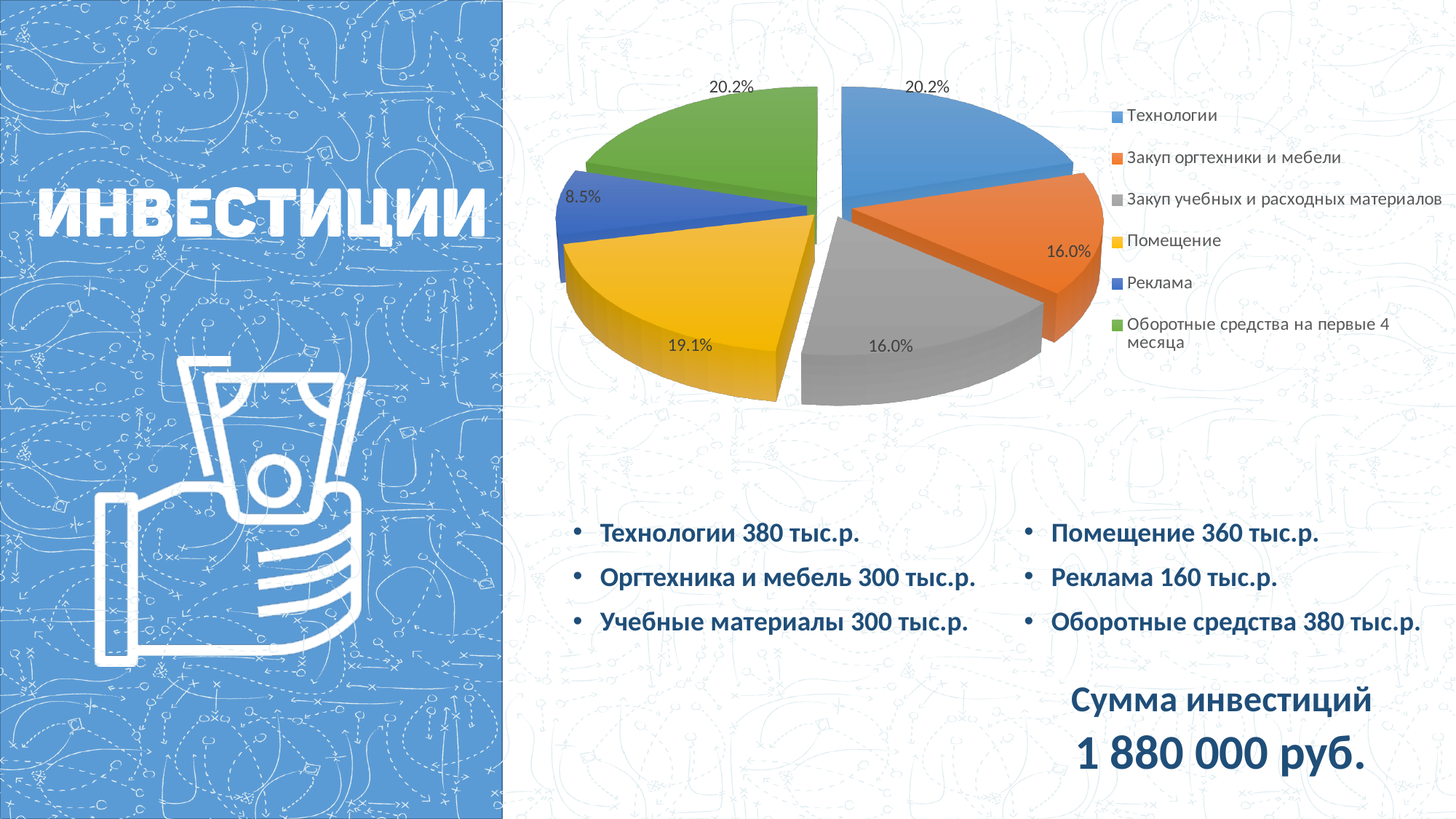
Which legend entry is shown in green? Оборотные средства на первые 4 месяца What share of the pie does Помещение have? 19.1% What share of the pie does Технологии have? 20.2% What kind of chart is shown on the slide? Pie chart Which category has the smallest slice of the pie? Реклама What is the difference in percentage points between the Технологии slice and the Реклама slice? 11.7 What colour is the Помещение slice in the pie chart? Yellow What share of the pie does Закуп оргтехники и мебели have? 16.0% Which slice is larger: Помещение or Реклама? Помещение How many slices does the pie chart have? 6